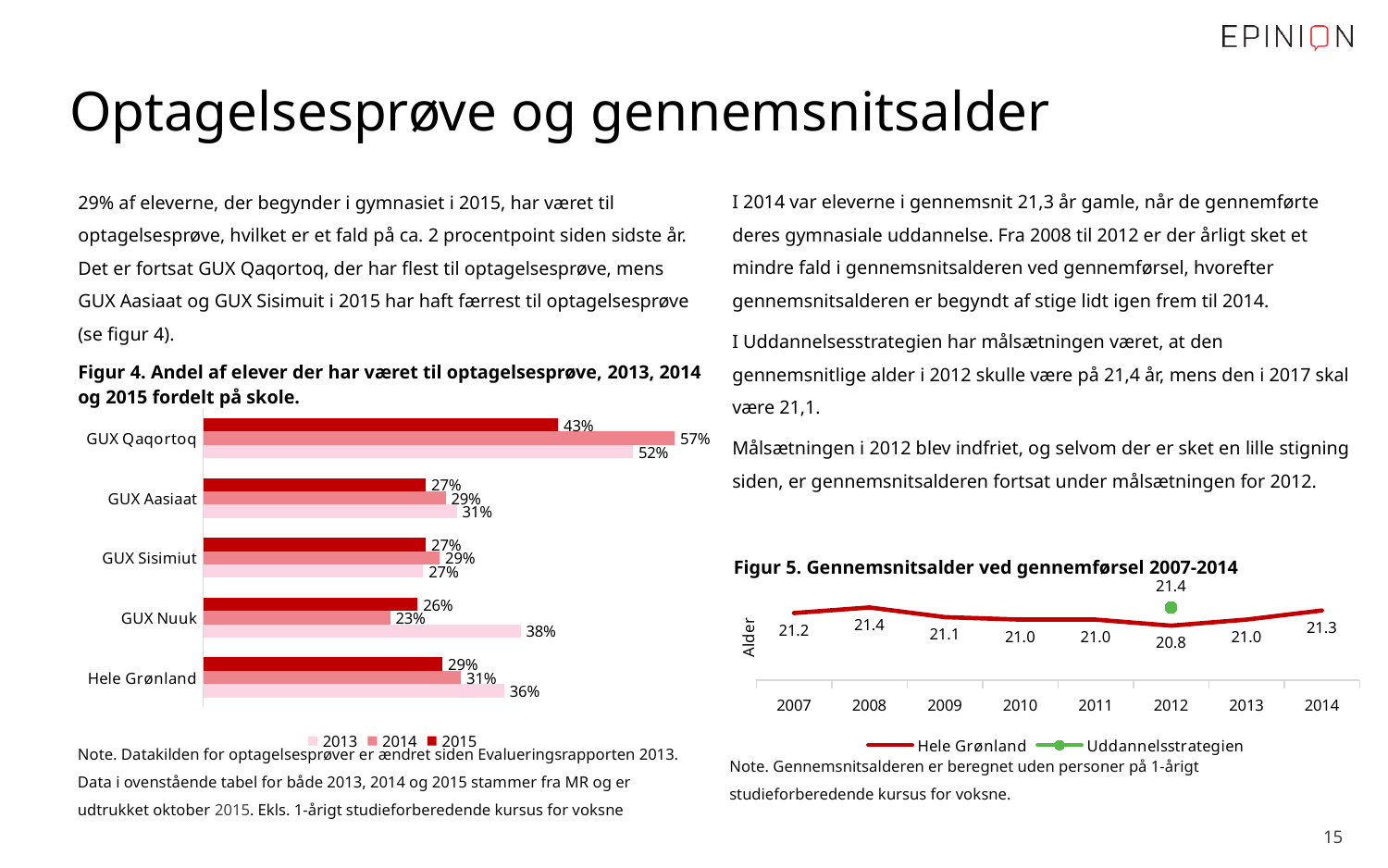
In Figur 4, how many schools/categories are shown? 5 In Figur 4, what is the value for GUX Nuuk in 2013? 38% In Figur 4, what is the difference between the 2014 and 2015 values for GUX Qaqortoq? 14 percentage points In Figur 4, what is the value for GUX Qaqortoq in 2014? 57% In Figur 5, what is the value for Hele Grønland in 2012? 20.8 In Figur 5, in which year is the Hele Grønland value lowest? 2012 In Figur 4, which school has the highest value in 2015? GUX Qaqortoq In Figur 4, how many series does the legend list? 3 In Figur 4, which category has the lowest value in 2014? GUX Nuuk In Figur 4, is the 2013 value for Hele Grønland larger or smaller than the 2015 value? larger What kind of chart is Figur 4? Bar chart In Figur 5, what is the value of the Uddannelsesstrategien point in 2012? 21.4